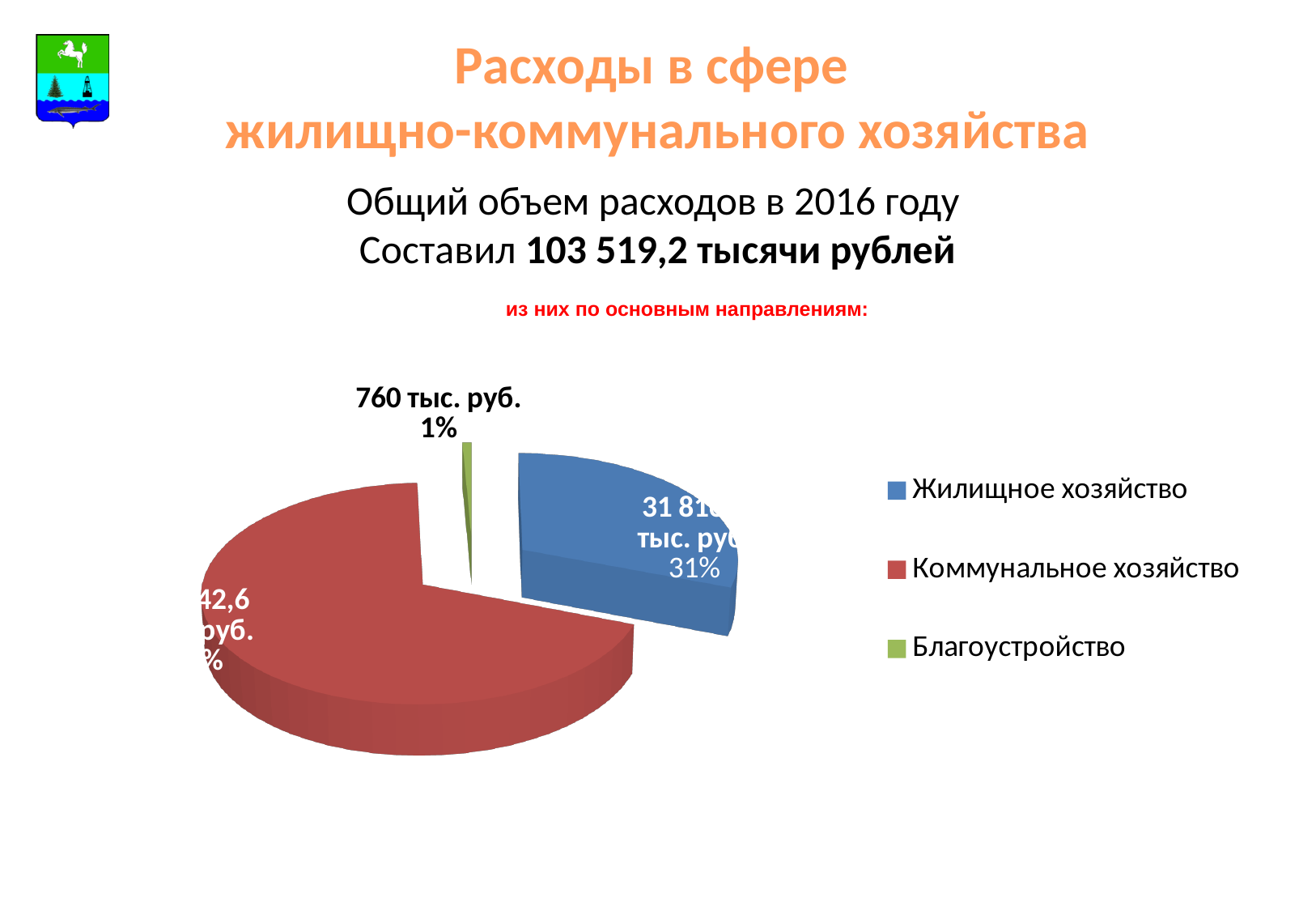
How many slices does the pie chart have? 3 What colour is the slice for Благоустройство? green What kind of chart is shown on the slide? pie chart Which legend entry is shown in red? Коммунальное хозяйство By how many percentage points does the share of Жилищное хозяйство exceed the share of Благоустройство? 30% Which category has the largest slice of the pie? Коммунальное хозяйство What share of the pie does Благоустройство represent? 1% What share of the pie does Жилищное хозяйство represent? 31% What is the value shown for Благоустройство? 760 тыс. руб. Which slice is larger, Жилищное хозяйство or Благоустройство? Жилищное хозяйство Which category has the smallest slice of the pie? Благоустройство How many entries does the legend of the pie chart list? 3